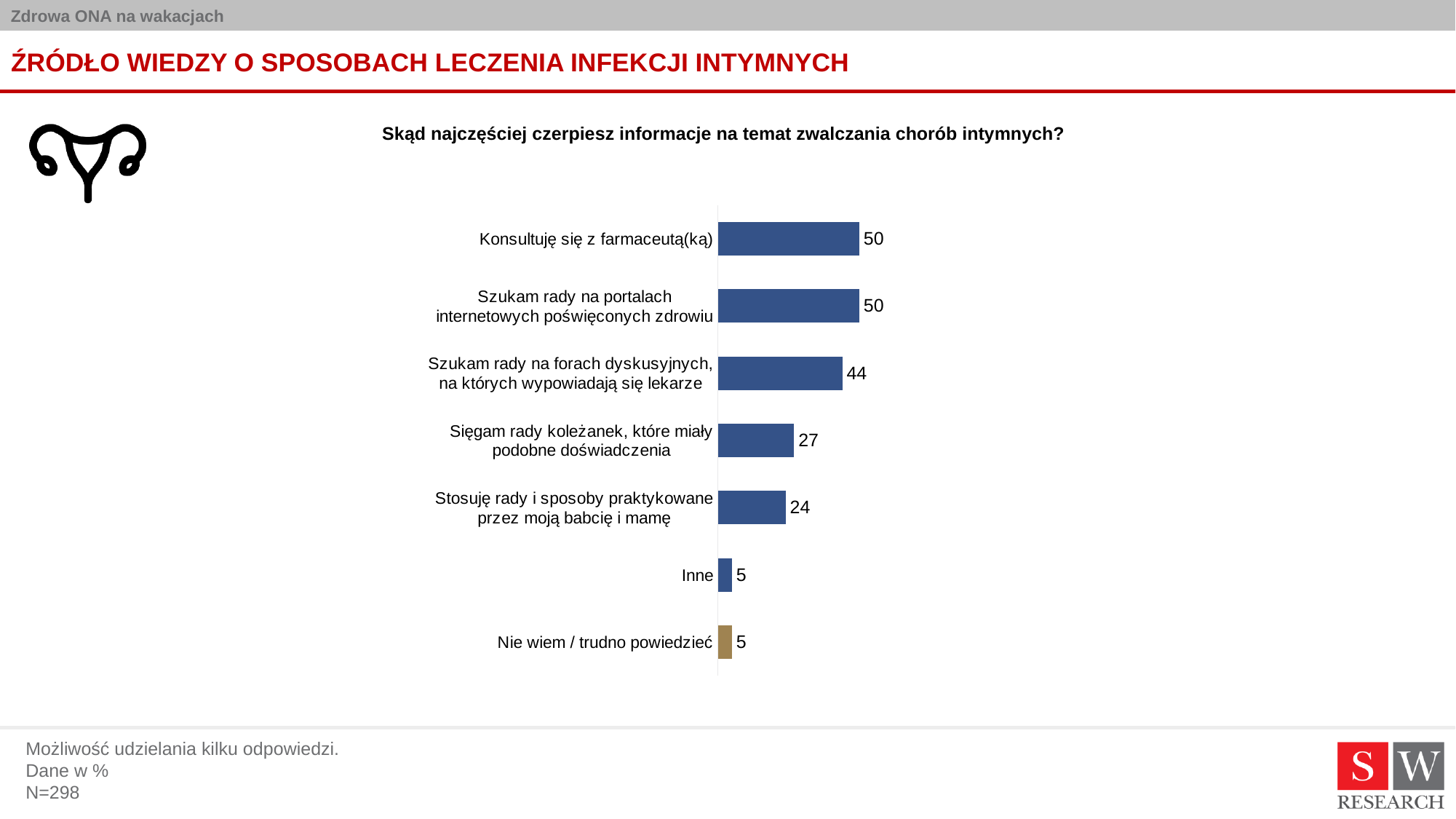
Which is larger: the value for "Szukam rady na forach dyskusyjnych, na których wypowiadają się lekarze" or the value for "Sięgam rady koleżanek, które miały podobne doświadczenia"? Szukam rady na forach dyskusyjnych, na których wypowiadają się lekarze What kind of chart is shown on the slide? bar chart How many categories are shown in the chart? 7 What value is shown for "Stosuję rady i sposoby praktykowane przez moją babcię i mamę"? 24 What is the difference between the values for "Szukam rady na portalach internetowych poświęconych zdrowiu" and "Szukam rady na forach dyskusyjnych, na których wypowiadają się lekarze"? 6 What value is shown for "Szukam rady na forach dyskusyjnych, na których wypowiadają się lekarze"? 44 What is the difference between the values for "Sięgam rady koleżanek, które miały podobne doświadczenia" and "Stosuję rady i sposoby praktykowane przez moją babcię i mamę"? 3 What question is the chart answering, as shown above it? Skąd najczęściej czerpiesz informacje na temat zwalczania chorób intymnych? What value is shown for "Konsultuję się z farmaceutą(ką)"? 50 What value is shown for "Inne"? 5 Which category's bar is shown in a different colour (brown) from the others? Nie wiem / trudno powiedzieć What value is shown for "Sięgam rady koleżanek, które miały podobne doświadczenia"? 27